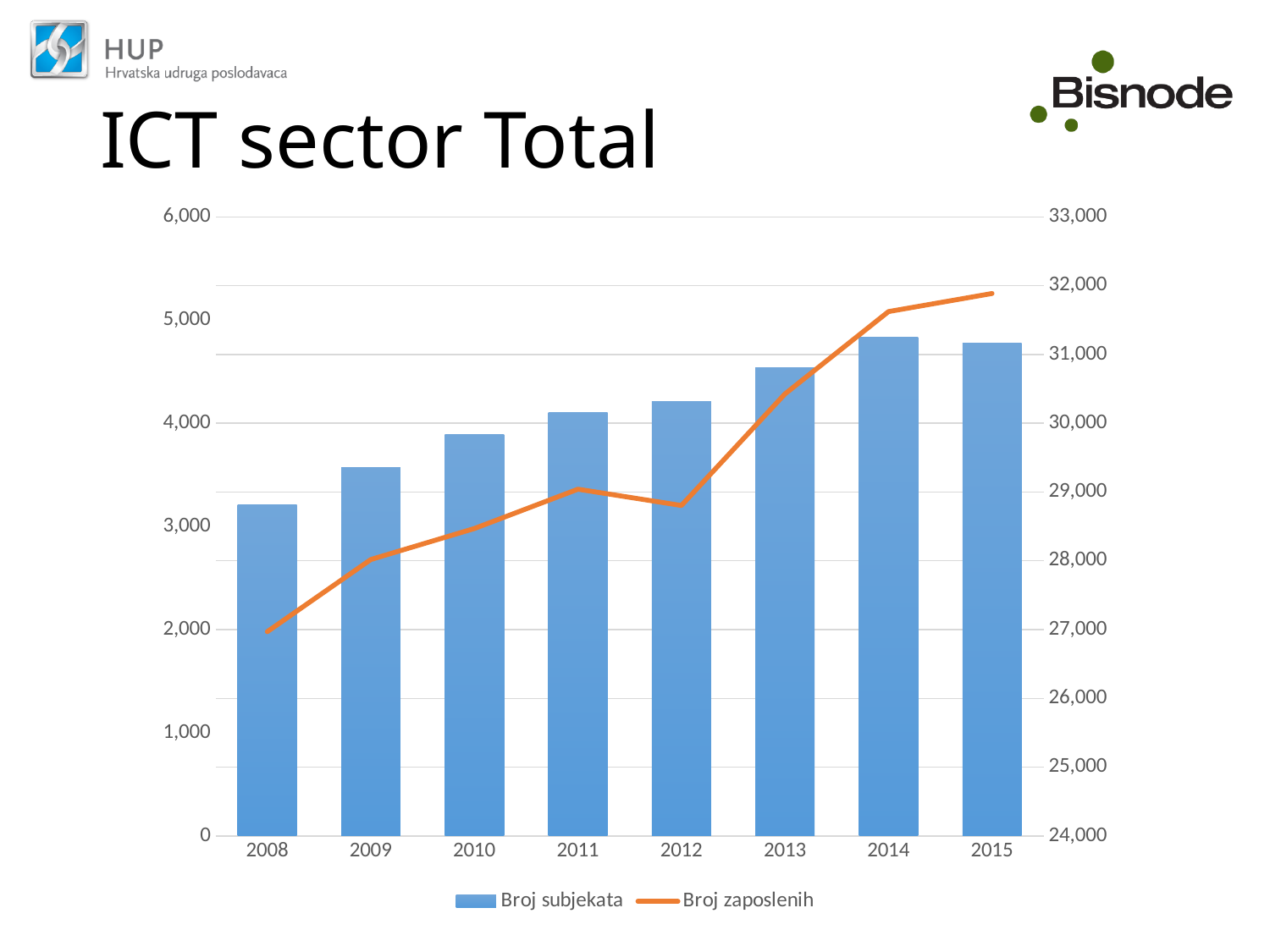
Is the Broj zaposlenih value for 2014 greater or less than 31,000? greater Which year has the lowest value for Broj subjekata (bars)? 2008 What is the title of the chart? ICT sector Total How many years are shown on the x axis? 8 What are the two series named in the legend? Broj subjekata and Broj zaposlenih How many series does the legend list? 2 Is the Broj subjekata value for 2015 greater or less than 5,000? less Which year has the highest value for Broj zaposlenih (line)? 2015 Which year has the larger Broj subjekata value, 2010 or 2013? 2013 Which year has the lowest value for Broj zaposlenih (line)? 2008 What kind of chart is this? A combination bar and line chart Is the Broj subjekata value for 2008 greater or less than 3,000? greater